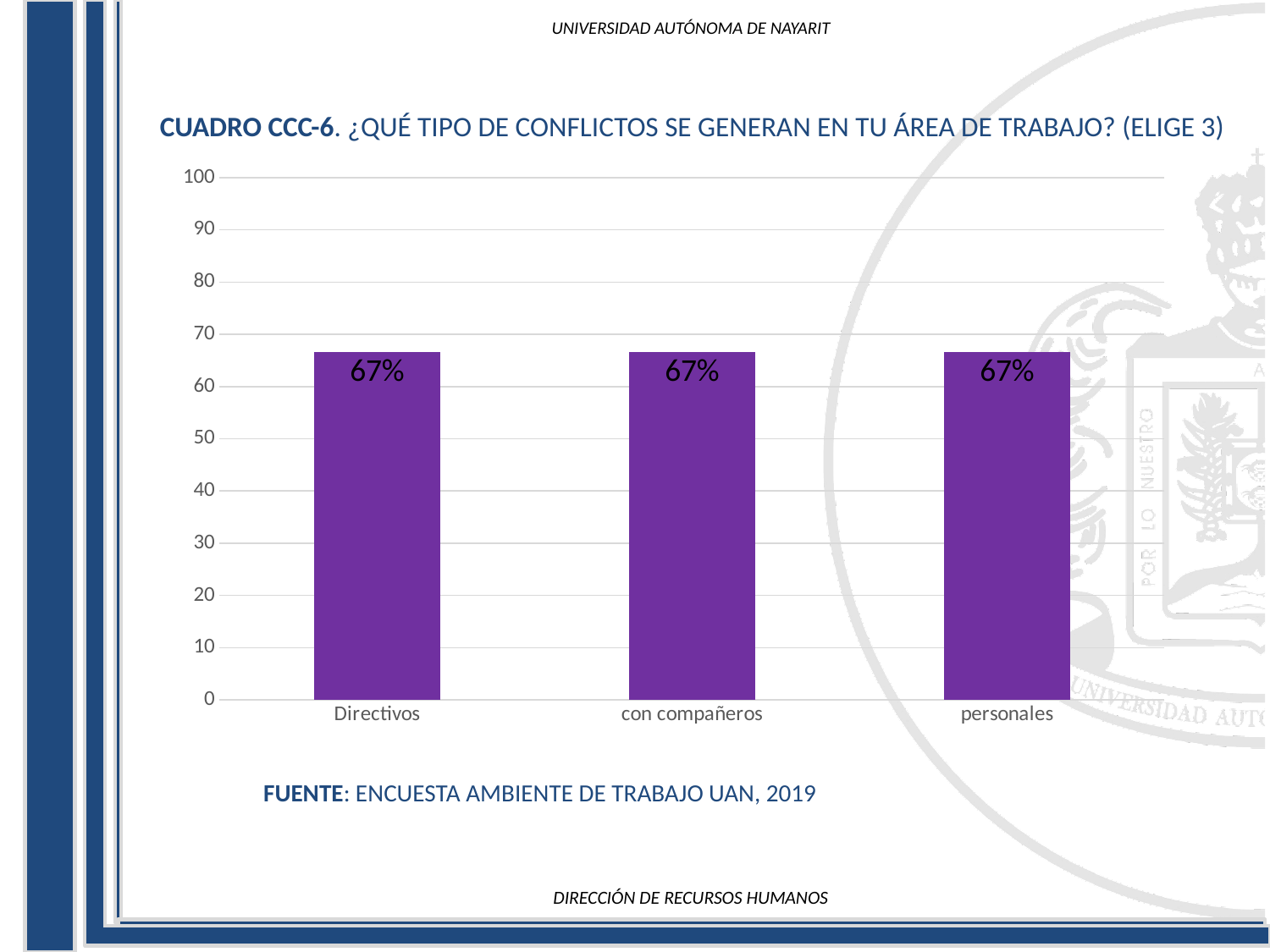
Is the value for personales greater or less than 70? less What is the value for Directivos? 67% Is the value for Directivos greater or less than 60? greater What is the value for personales? 67% What kind of chart is shown on the slide? bar chart What is the value for con compañeros? 67% What source is cited below the chart? ENCUESTA AMBIENTE DE TRABAJO UAN, 2019 What is the highest value shown on the vertical axis? 100 Do the values rise, fall, or stay the same across the categories from left to right? stay the same What is the difference between the values for Directivos and con compañeros? 0 How many categories are shown on the x axis? 3